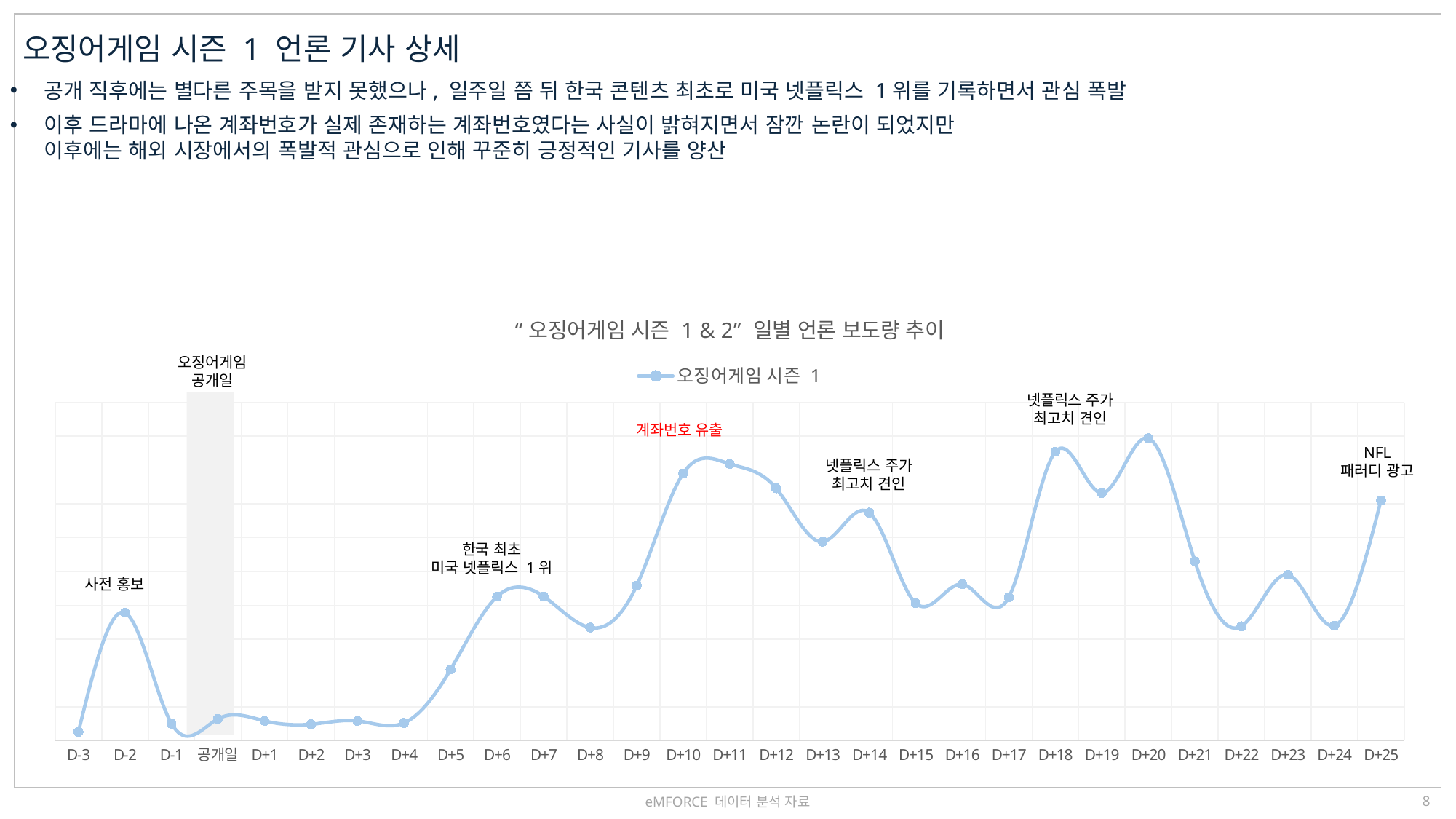
Do the values rise or fall from D+20 to D+22? fall On which day does the line reach its highest value? D+20 What kind of chart is shown on the slide? line chart On which day does the line reach its lowest value? D-3 What is the name of the series shown in the legend? 오징어게임 시즌 1 Which day has the larger value, D-2 or D+5? D-2 Do the values rise or fall from D+4 to D+6? rise What is the title of the chart? "오징어게임 시즌 1 & 2" 일별 언론 보도량 추이 How many series does the legend list? 1 Which day has the larger value, D+10 or D+6? D+10 How many points (days) are plotted along the x axis? 29 Which day has the larger value, D+18 or D+19? D+18